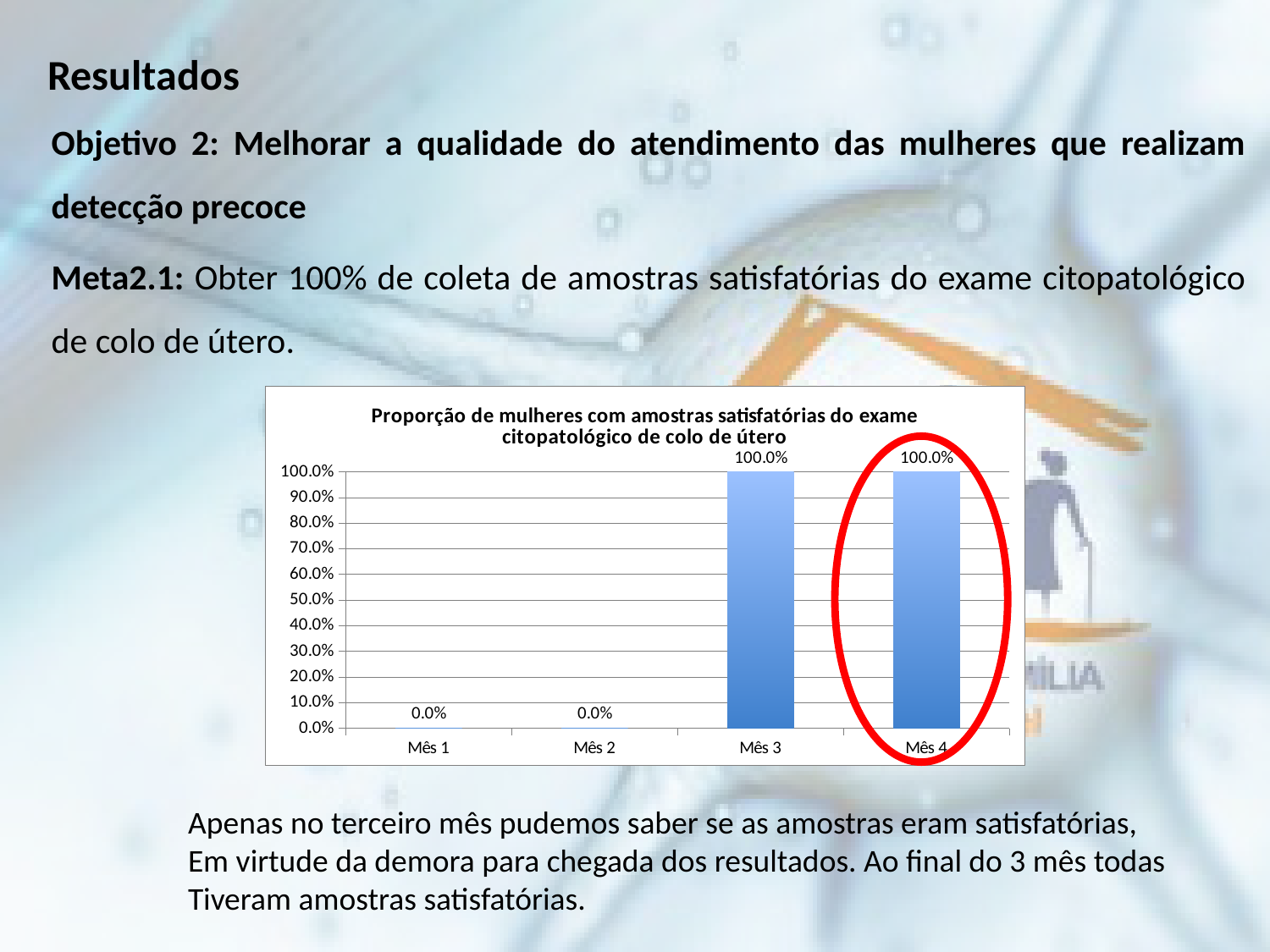
Which category is circled in red on the chart? Mês 4 What is the difference between the values for Mês 3 and Mês 2? 100.0% How many categories are shown on the x axis? 4 What is the highest value shown on the y axis? 100.0% Which is larger, the value for Mês 1 or the value for Mês 3? Mês 3 What is the title of the chart? Proporção de mulheres com amostras satisfatórias do exame citopatológico de colo de útero What is the value for Mês 4? 100.0% What is the value for Mês 1? 0.0% What kind of chart is shown on the slide? bar chart Do the values rise or fall from Mês 1 to Mês 4? rise What is the value for Mês 2? 0.0% What is the value for Mês 3? 100.0%